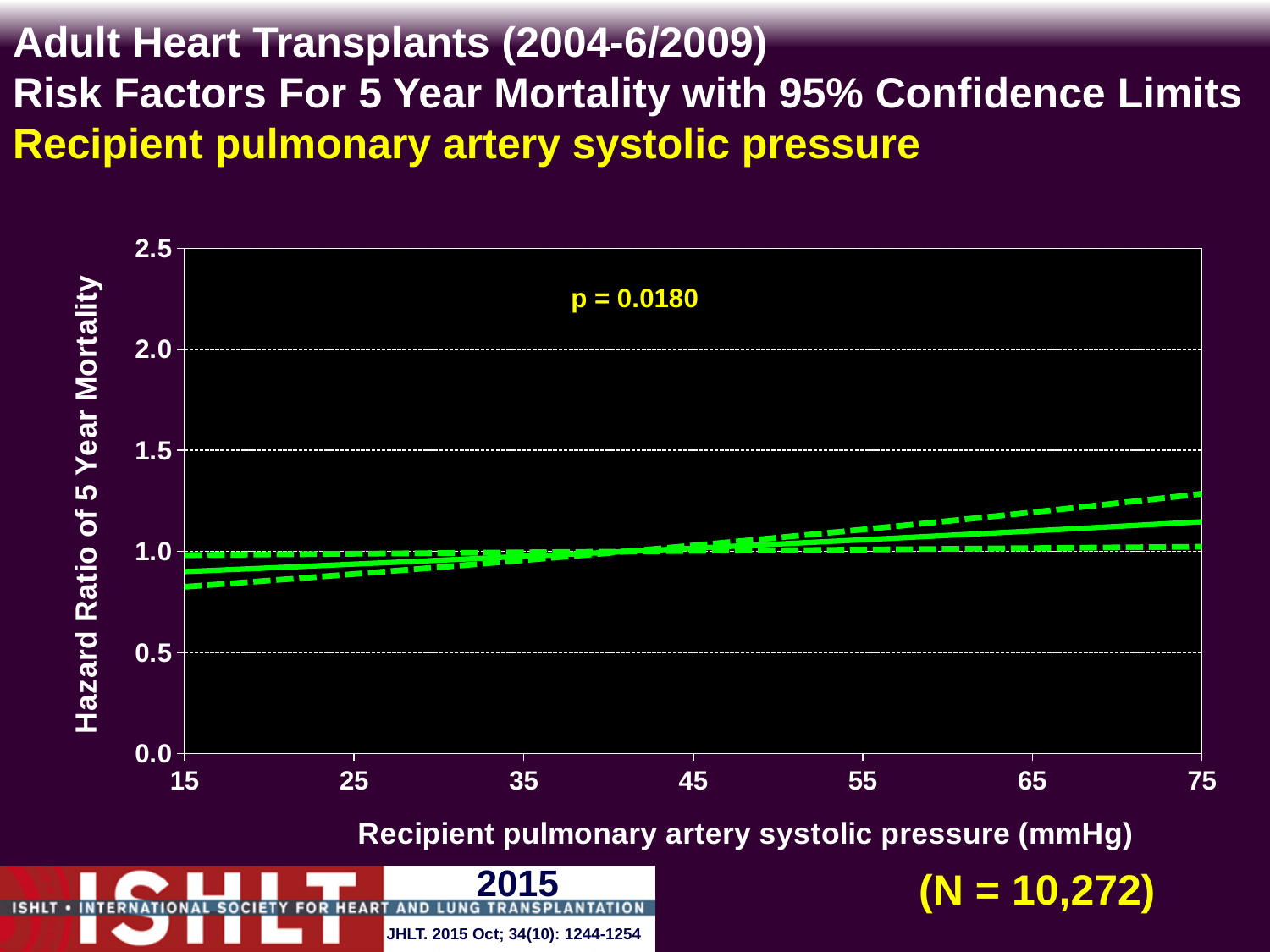
What is the label of the y axis? Hazard Ratio of 5 Year Mortality Is the hazard ratio (solid line) at 75 mmHg greater or less than 1.5? less What is the sample size (N) shown on the slide? N = 10,272 Is the upper confidence limit (upper dashed line) at 75 mmHg greater or less than 1.5? less Which is larger, the hazard ratio (solid line) at 15 mmHg or at 75 mmHg? 75 mmHg What kind of chart is shown on the slide? line chart Is the lower confidence limit (lower dashed line) at 15 mmHg greater or less than 1.0? less Does the hazard ratio (solid line) rise or fall as recipient pulmonary artery systolic pressure increases from 15 to 75 mmHg? rise What p-value is printed on the chart? p = 0.0180